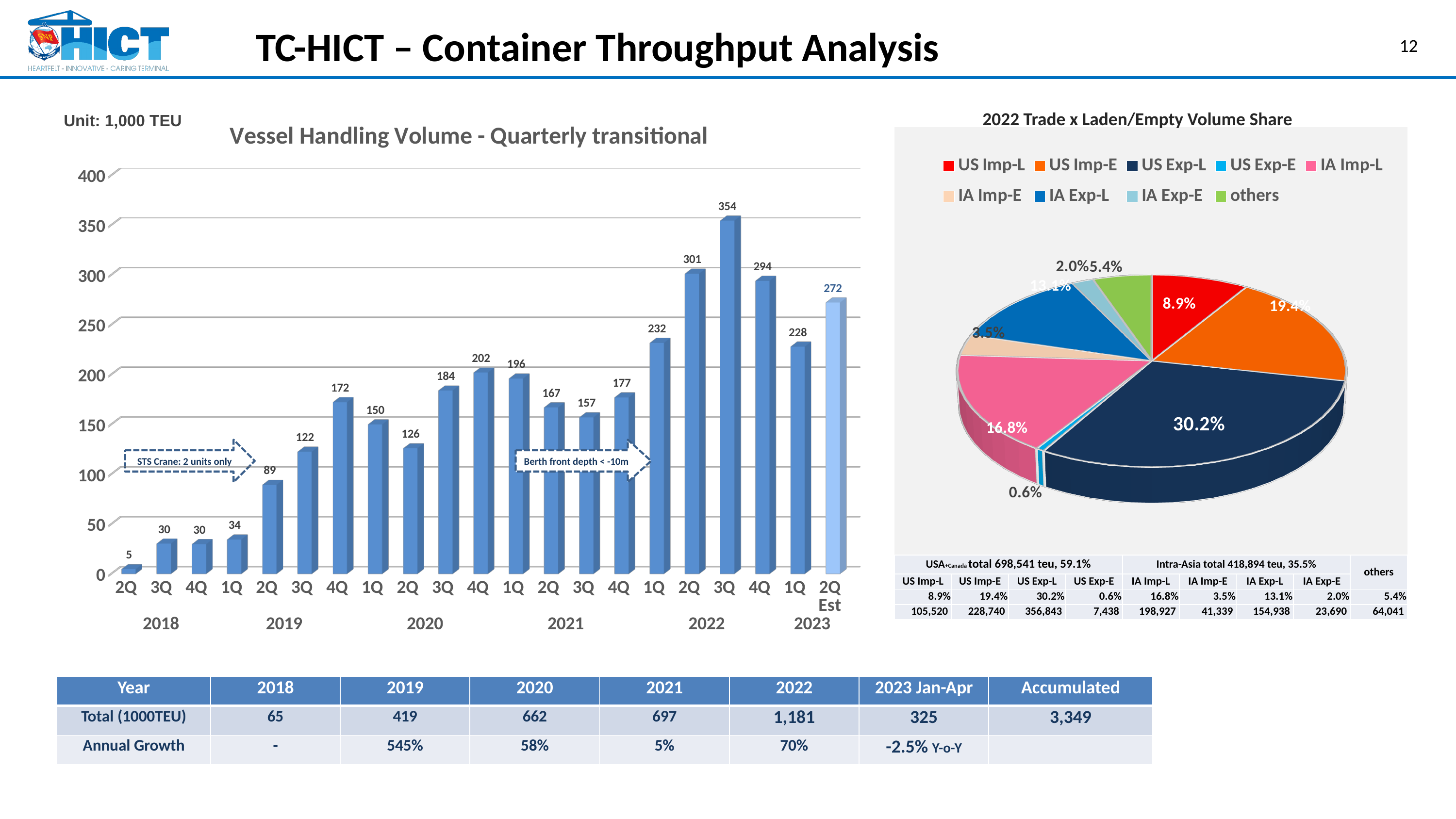
In the Vessel Handling Volume chart, what is the value for 3Q 2022? 354 In the 2022 Trade x Laden/Empty Volume Share pie chart, what share does US Exp-L have? 30.2% What type of chart is the Vessel Handling Volume - Quarterly transitional chart? Bar chart In the Vessel Handling Volume chart, which is larger, 4Q 2020 or 1Q 2021? 4Q 2020 In the Vessel Handling Volume chart, which quarter has the highest value? 3Q 2022 In the 2022 Trade x Laden/Empty Volume Share pie chart, which category has the smallest share? US Exp-E In the Vessel Handling Volume chart, do the values rise or fall from 1Q 2019 to 4Q 2019? Rise How many entries does the legend of the 2022 Trade x Laden/Empty Volume Share pie chart list? 9 In the Vessel Handling Volume chart, what is the estimated value for 2Q 2023? 272 In the Vessel Handling Volume chart, which quarter has the lowest value? 2Q 2018 How many quarterly bars are plotted in the Vessel Handling Volume chart? 21 In the Vessel Handling Volume chart, what is the difference between 2Q 2022 and 1Q 2022? 69